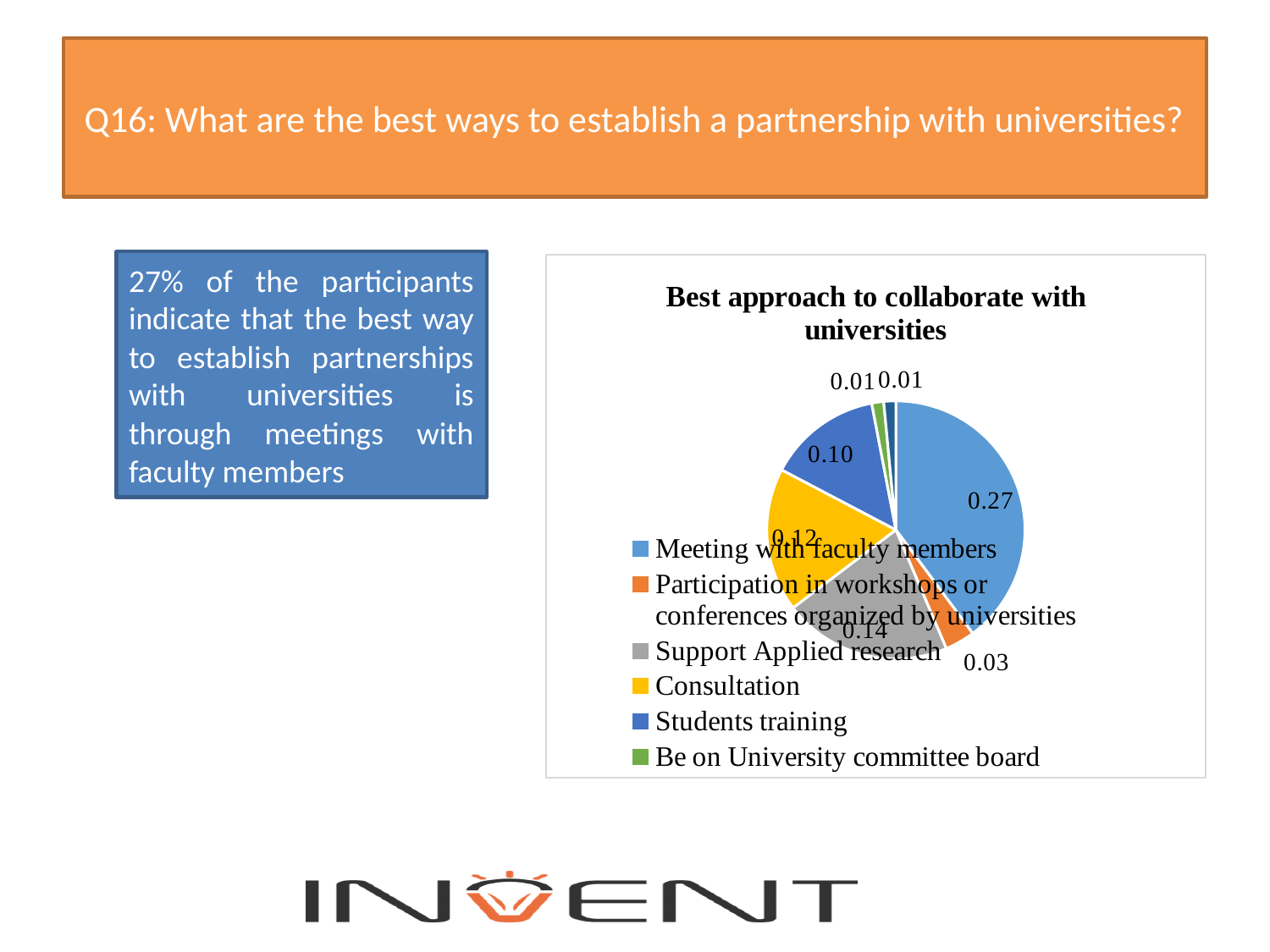
What is the difference between the values for Meeting with faculty members and Participation in workshops or conferences organized by universities? 0.24 Which category has the largest slice of the pie chart? Meeting with faculty members What value is shown for Be on University committee board? 0.01 Which is larger: Meeting with faculty members or Students training? Meeting with faculty members What value is shown for Meeting with faculty members in the pie chart? 0.27 What is the difference between the values for Meeting with faculty members and Students training? 0.17 What colour represents Consultation in the pie chart? yellow What value is shown for Students training in the pie chart? 0.10 What value is shown for Participation in workshops or conferences organized by universities? 0.03 What kind of chart is shown on the slide? pie chart How many categories does the legend of the pie chart list? 6 What is the title of the pie chart? Best approach to collaborate with universities